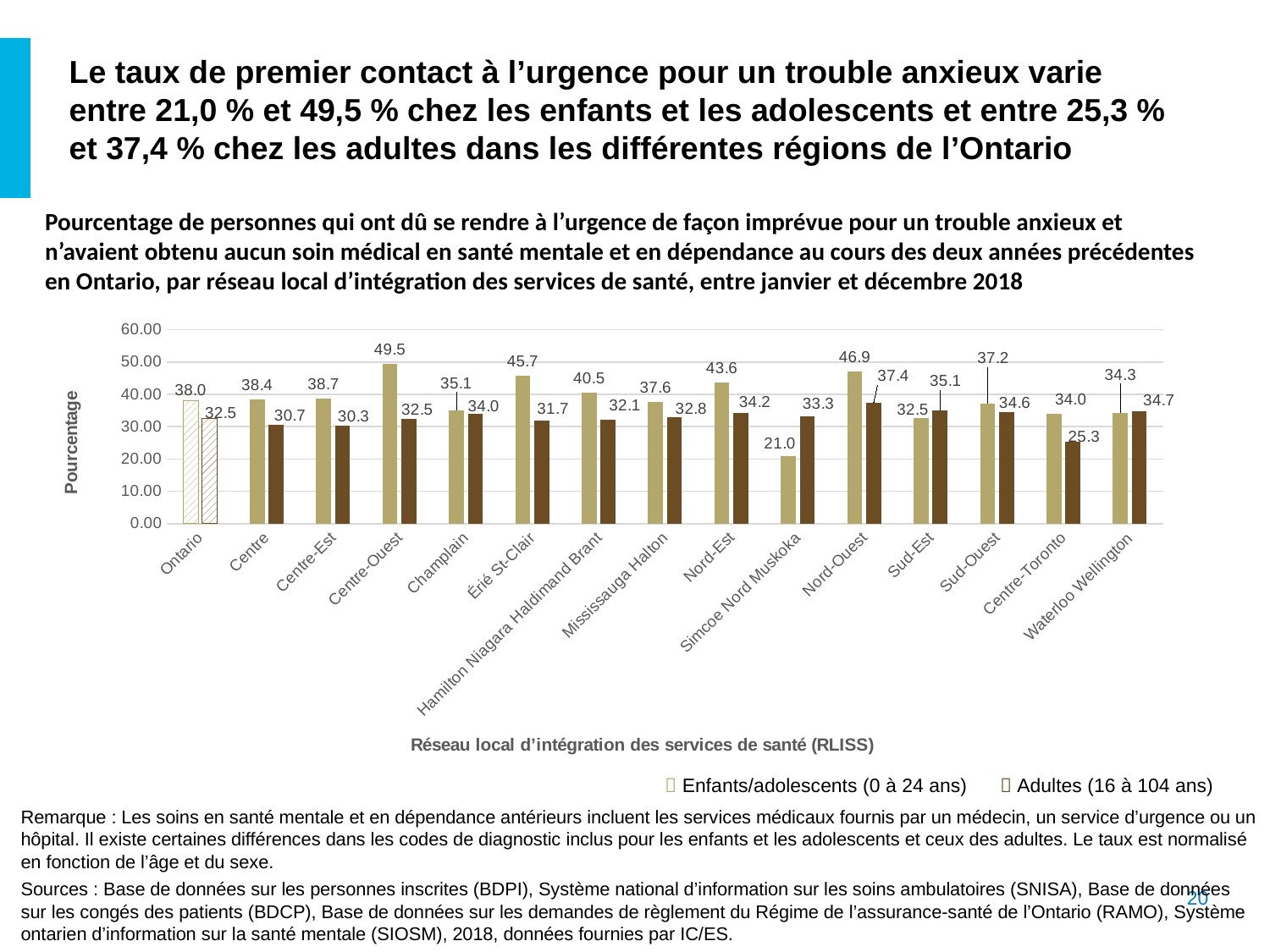
What is the value for Enfants/adolescents (0 à 24 ans) in Simcoe Nord Muskoka? 21.0 What is the label of the y axis? Pourcentage In Sud-Est, which is larger: the Enfants/adolescents (0 à 24 ans) value or the Adultes (16 à 104 ans) value? Adultes (16 à 104 ans) What kind of chart is shown on the slide? Bar chart Which region has the lowest value for Enfants/adolescents (0 à 24 ans)? Simcoe Nord Muskoka What is the value for Adultes (16 à 104 ans) in Nord-Ouest? 37.4 Which region has the lowest value for Adultes (16 à 104 ans)? Centre-Toronto What is the difference between the Enfants/adolescents and Adultes values in Centre-Ouest? 17.0 How many regions (categories) are shown on the x axis? 15 Which region has the highest value for Enfants/adolescents (0 à 24 ans)? Centre-Ouest How many series does the legend list? 2 What is the value for Enfants/adolescents (0 à 24 ans) in Centre-Ouest? 49.5